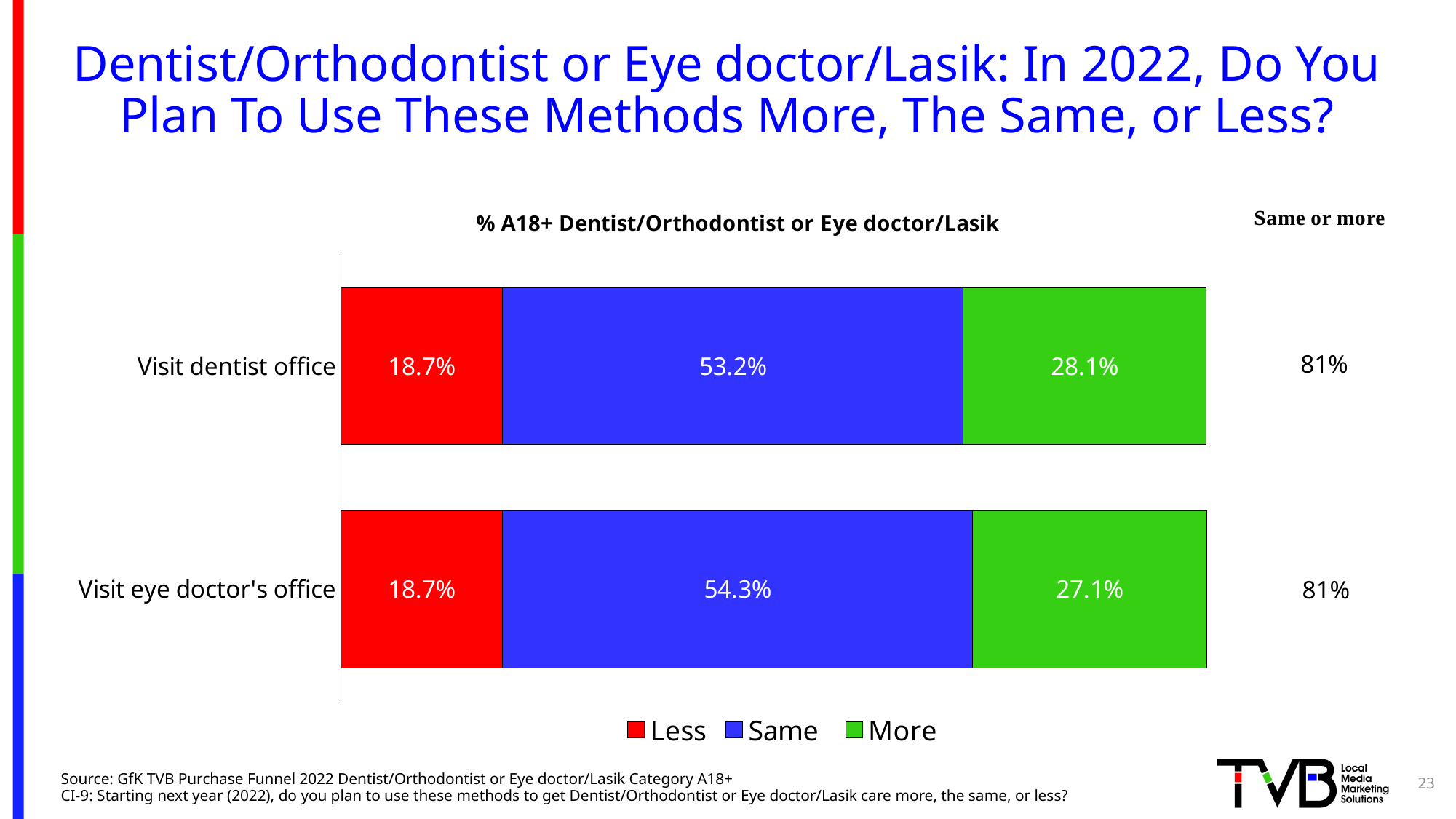
Which colour represents the 'Less' series in the chart? Red What percentage of A18+ plan to visit the dentist office the same amount in 2022? 53.2% How many series does the legend list? 3 What type of chart is shown on the slide? Stacked bar chart What is the difference between the 'More' percentages for Visit dentist office and Visit eye doctor's office? 1.0% What percentage of A18+ plan to visit the eye doctor's office less in 2022? 18.7% What percentage of A18+ plan to visit the eye doctor's office more in 2022? 27.1% What is the 'Same or more' figure shown for Visit dentist office? 81% Which category has the higher 'Same' percentage, Visit dentist office or Visit eye doctor's office? Visit eye doctor's office What is the difference between the 'Same' percentages for Visit eye doctor's office and Visit dentist office? 1.1% Which category has the higher 'More' percentage? Visit dentist office How many categories are plotted in the chart? 2